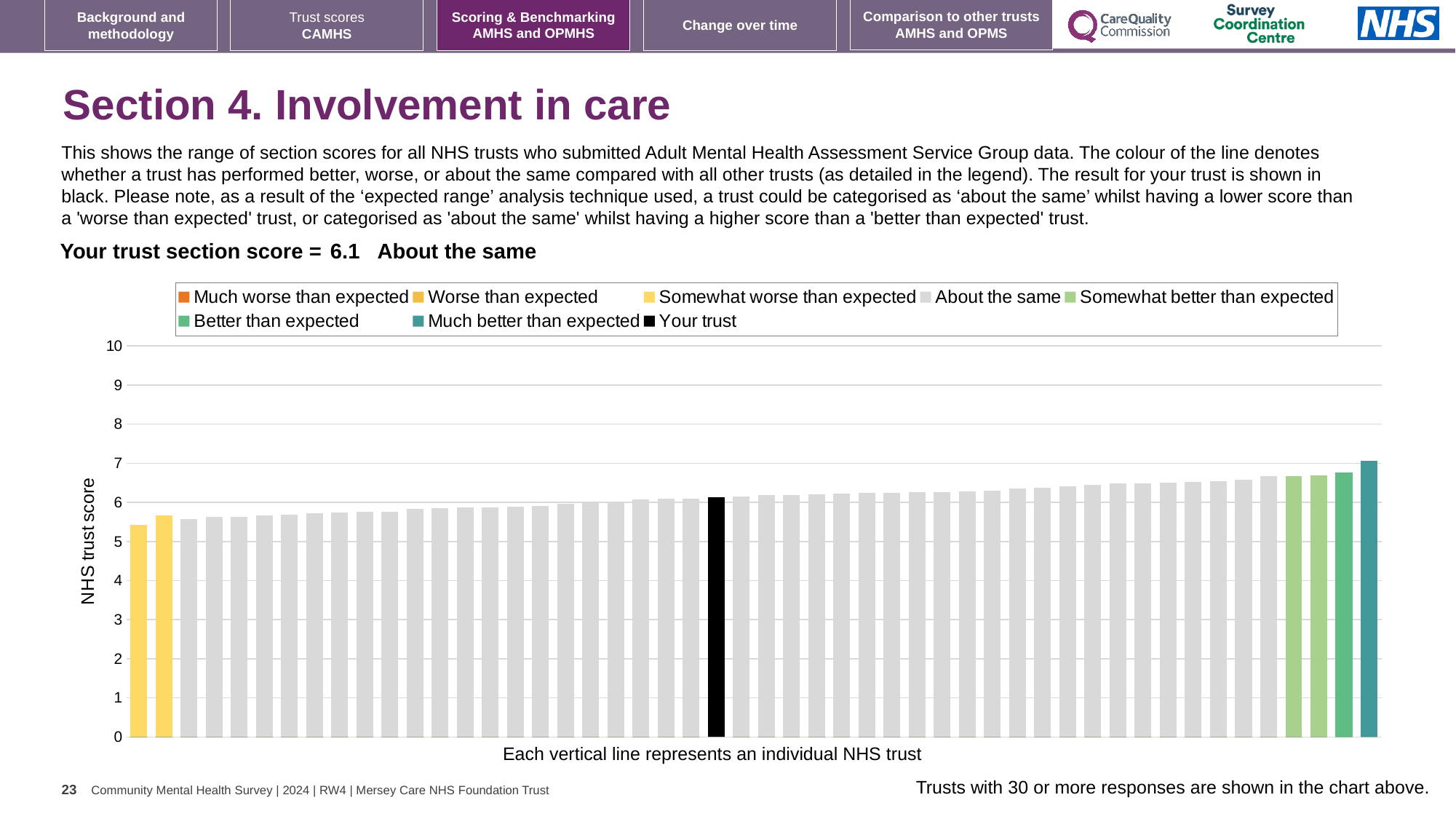
Is the bar for your trust taller or shorter than the leftmost bar? taller How many entries does the chart legend list? 8 What is the title of the vertical axis? NHS trust score Do the bar values rise or fall from left to right along the x axis? rise Is the value of the tallest bar greater or less than 8? less How many bars are coloured as 'Worse than expected' (yellow)? 0 What is the section score for your trust shown on the slide? 6.1 Which legend category does the tallest bar belong to? Much better than expected Which legend category does the shortest bar belong to? Somewhat worse than expected What kind of chart is shown on the slide? bar chart Is the value of the shortest bar greater or less than 5? greater Which category is your trust placed in for this section? About the same